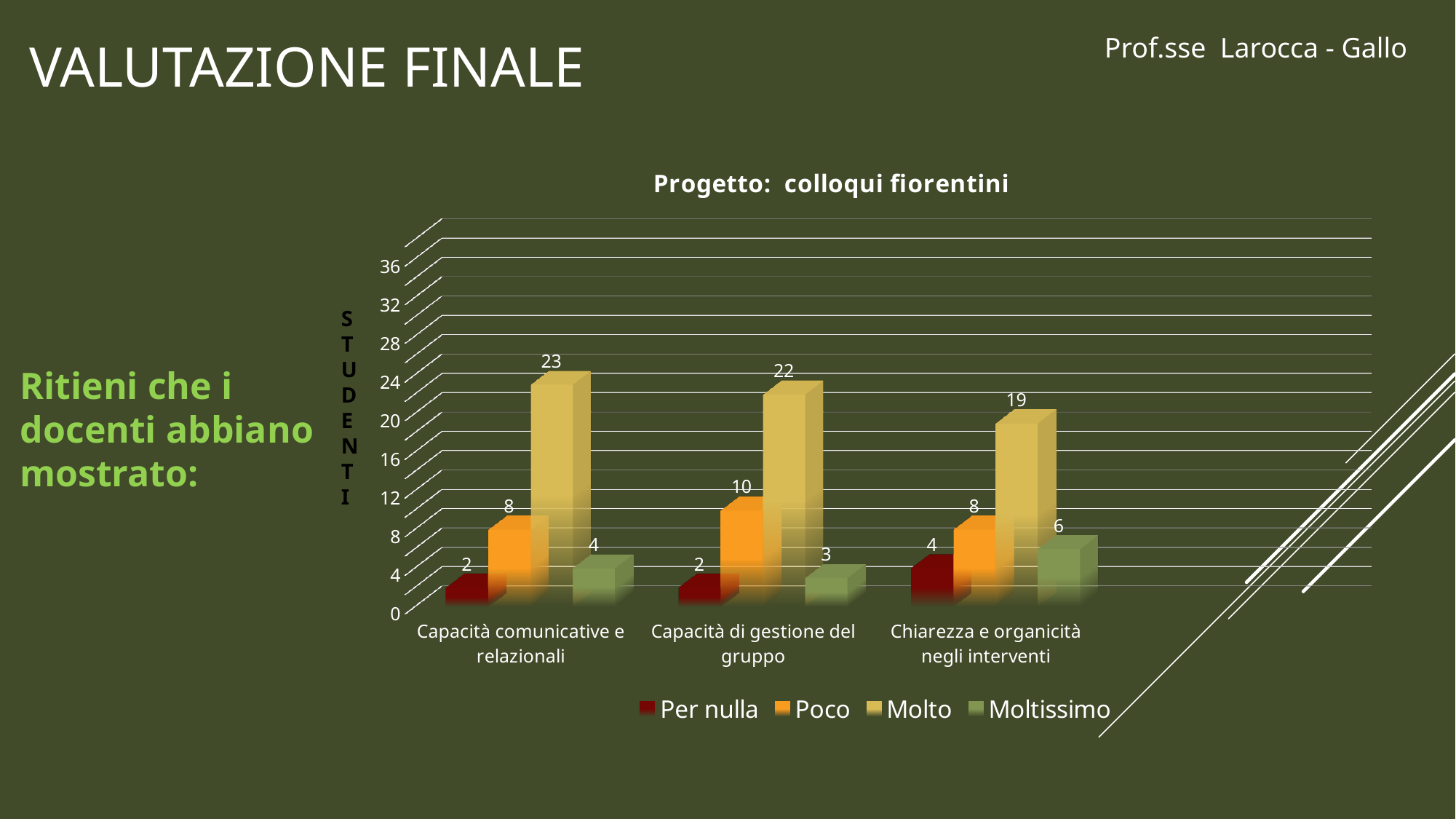
What is the value of "Moltissimo" for "Chiarezza e organicità negli interventi"? 6 What is the value of "Per nulla" for "Chiarezza e organicità negli interventi"? 4 What is the value of "Poco" for "Capacità di gestione del gruppo"? 10 Which is larger: the "Poco" value for "Capacità di gestione del gruppo" or the "Poco" value for "Chiarezza e organicità negli interventi"? Capacità di gestione del gruppo What is the difference between the "Molto" values for "Capacità comunicative e relazionali" and "Chiarezza e organicità negli interventi"? 4 What is the title of the chart? Progetto: colloqui fiorentini What is the value of "Molto" for "Capacità comunicative e relazionali"? 23 Which category has the highest value for the "Molto" series? Capacità comunicative e relazionali How many series does the legend list? 4 What kind of chart is shown on the slide? Bar chart How many categories are shown on the x axis of the chart? 3 Which category has the lowest value for the "Moltissimo" series? Capacità di gestione del gruppo